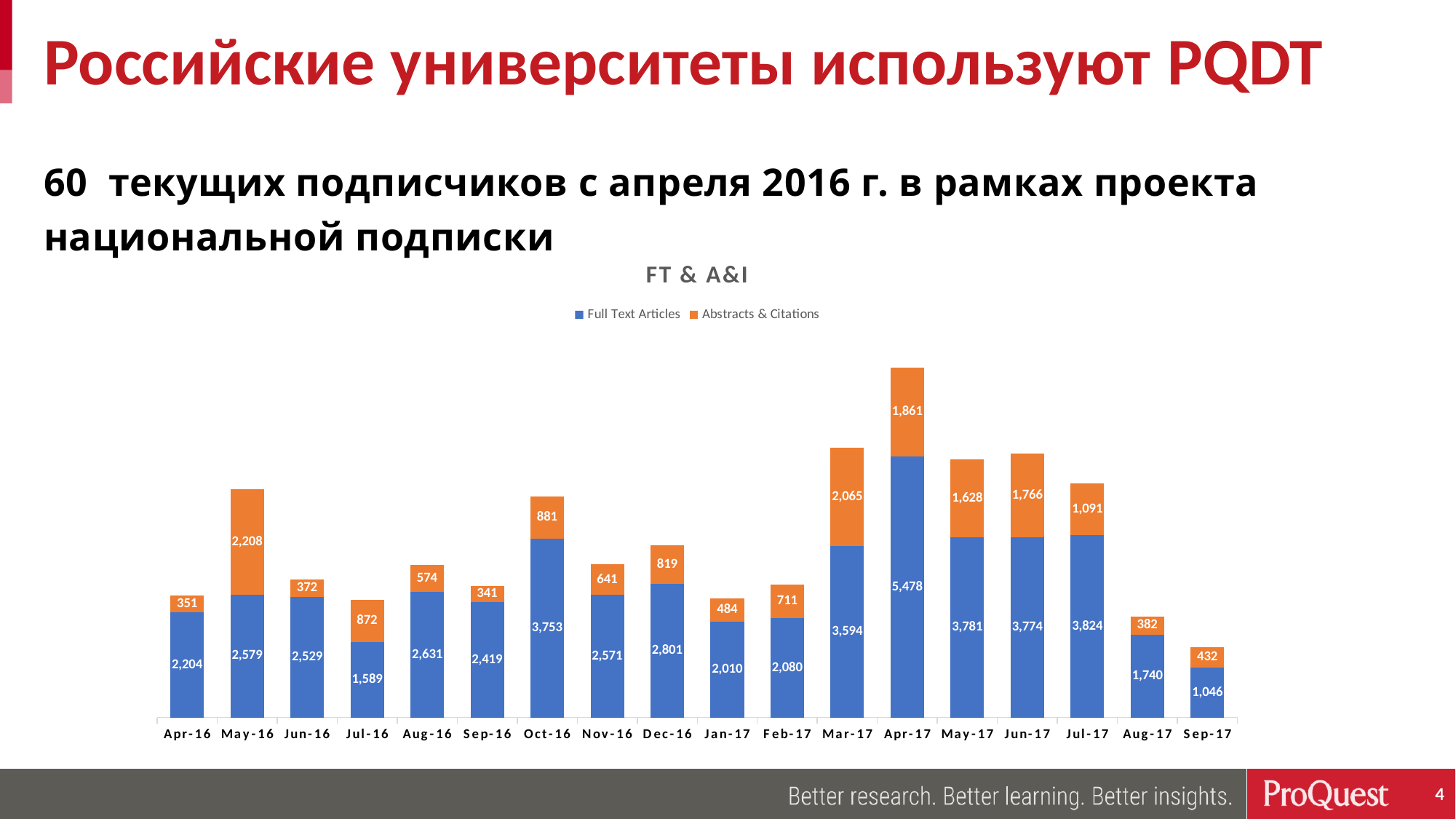
How many series does the legend of the FT & A&I chart list? 2 What is the Abstracts & Citations value for May-16? 2,208 Which month has the lowest Abstracts & Citations value? Sep-16 What is the difference between the Full Text Articles values for Apr-17 and Mar-17? 1,884 Which month has the highest Full Text Articles value? Apr-17 What type of chart is shown on the slide? Stacked bar chart Which month has the lowest Full Text Articles value? Sep-17 How many months are shown on the x axis of the FT & A&I chart? 18 What is the Full Text Articles value for Apr-17? 5,478 What is the title of the chart? FT & A&I What is the total of the stacked bar for Apr-17? 7,339 Which is larger, the Abstracts & Citations value for Mar-17 or for Apr-17? Mar-17